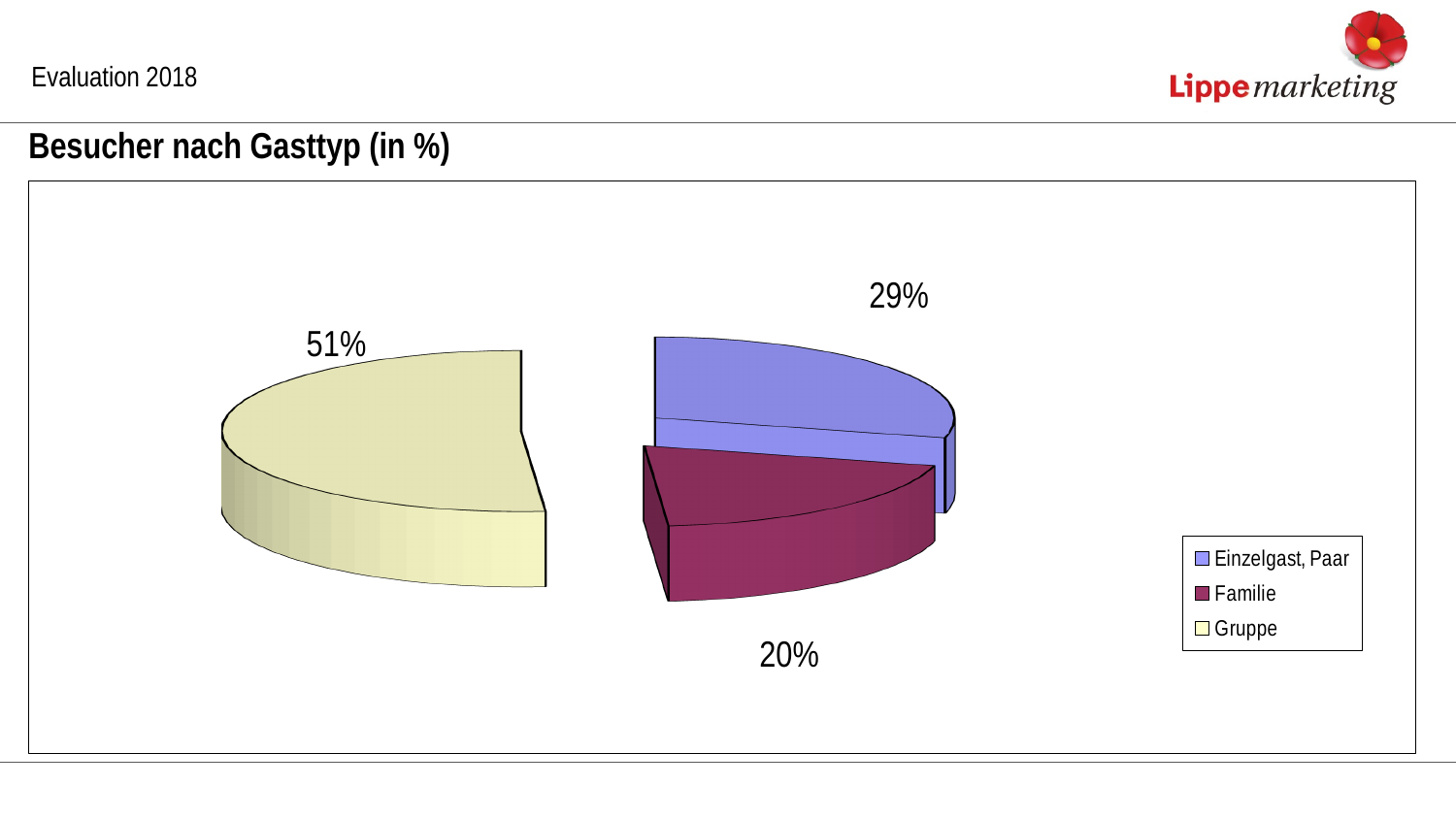
How many slices does the pie chart have? 3 What is the title of the chart? Besucher nach Gasttyp (in %) What type of chart is shown on the slide? pie chart What colour is the Familie slice? dark red What is the difference in percentage points between Einzelgast, Paar and Familie? 9 What percentage of visitors are Einzelgast, Paar? 29% What percentage of visitors are Gruppe? 51% Which is larger, the share for Einzelgast, Paar or the share for Familie? Einzelgast, Paar What percentage of visitors are Familie? 20% Which guest type has the largest share? Gruppe Which guest type has the smallest share? Familie What is the difference in percentage points between Gruppe and Familie? 31